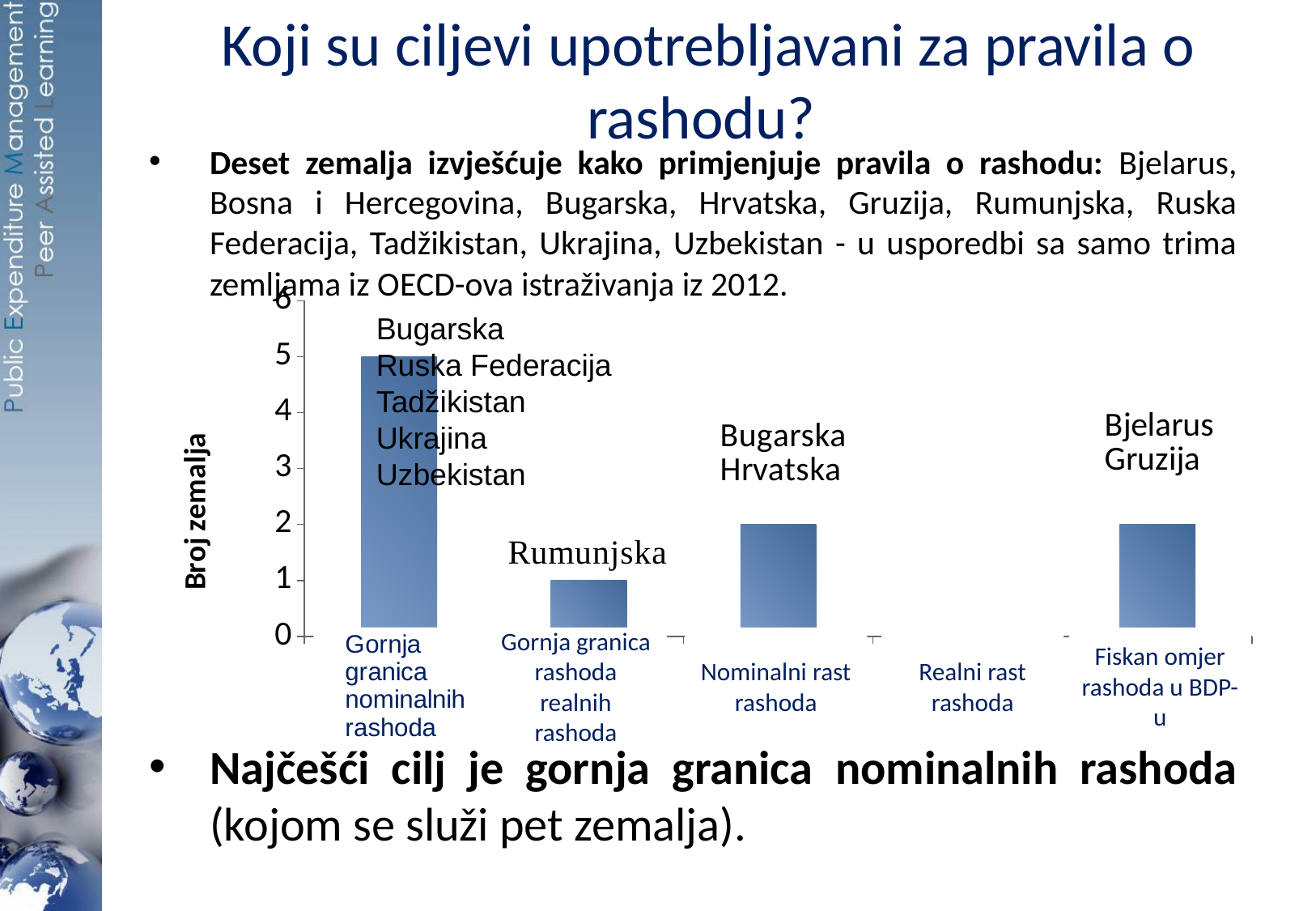
What is the difference in the number of countries between 'Gornja granica nominalnih rashoda' and 'Nominalni rast rashoda'? 3 How many countries use 'Gornja granica rashoda realnih rashoda' according to the chart? 1 How many countries use 'Fiskan omjer rashoda u BDP-u' according to the chart? 2 How many countries use 'Nominalni rast rashoda' according to the chart? 2 Is the value for 'Gornja granica nominalnih rashoda' greater or less than 4? greater Which has more countries: 'Nominalni rast rashoda' or 'Gornja granica rashoda realnih rashoda'? Nominalni rast rashoda How many categories are shown on the x axis of the chart? 5 Which category has the highest number of countries in the chart? Gornja granica nominalnih rashoda What is the label of the vertical axis of the chart? Broj zemalja What type of chart is shown on the slide? bar chart How many countries use 'Gornja granica nominalnih rashoda' according to the chart? 5 Which category has no bar (zero countries) in the chart? Realni rast rashoda